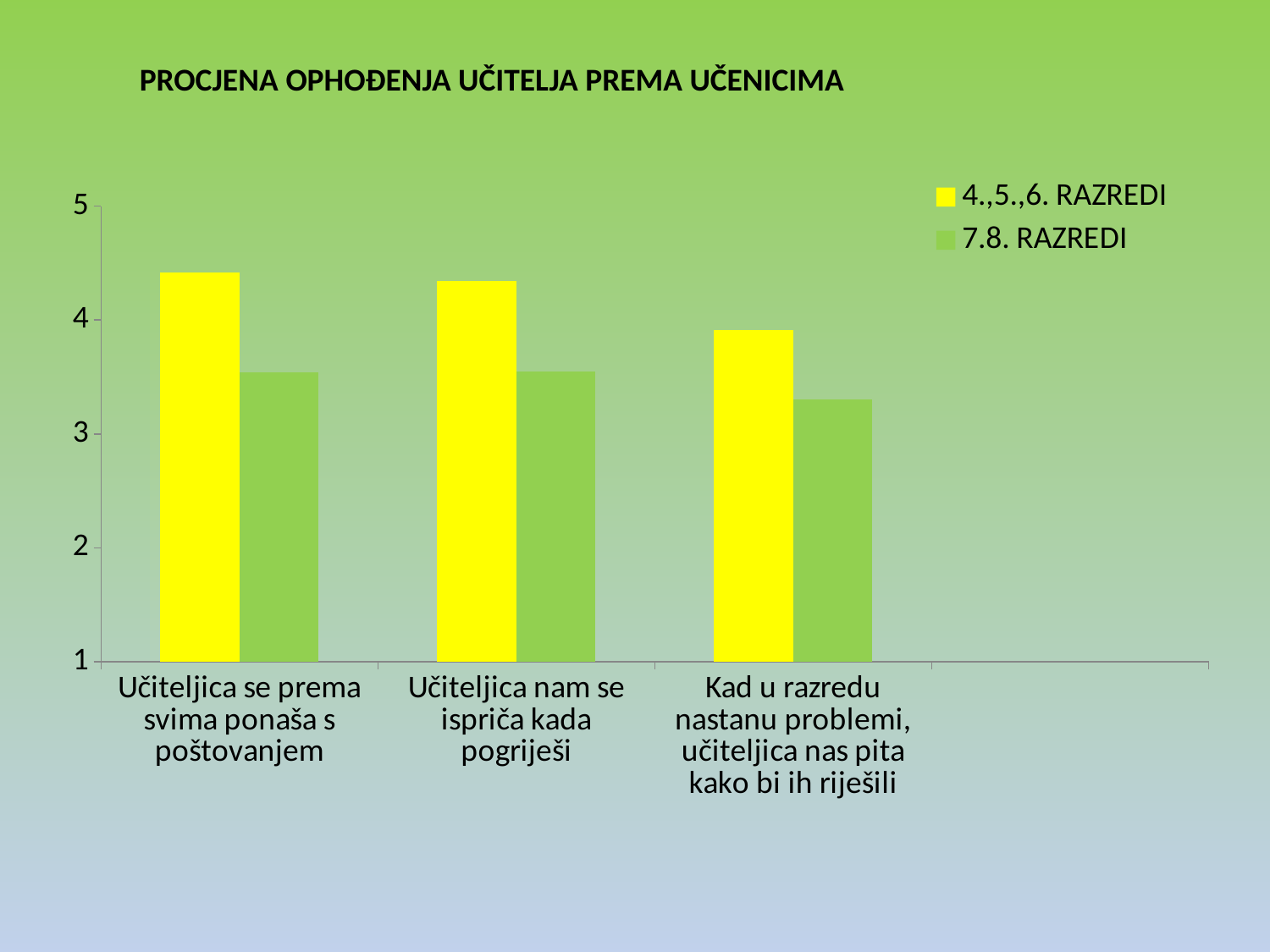
For the series 7.8. RAZREDI, which category has the lowest value? Kad u razredu nastanu problemi, učiteljica nas pita kako bi ih riješili Which series is shown in yellow in the chart? 4.,5.,6. RAZREDI Is the value for 7.8. RAZREDI in the category 'Kad u razredu nastanu problemi, učiteljica nas pita kako bi ih riješili' greater or less than 3? greater Is the value for 4.,5.,6. RAZREDI in the category 'Učiteljica se prema svima ponaša s poštovanjem' greater or less than 4? greater Is the value for 4.,5.,6. RAZREDI in the category 'Kad u razredu nastanu problemi, učiteljica nas pita kako bi ih riješili' greater or less than 4? less For the series 4.,5.,6. RAZREDI, which category has the lowest value? Kad u razredu nastanu problemi, učiteljica nas pita kako bi ih riješili How many series does the legend list? 2 What is the title of the chart? PROCJENA OPHOĐENJA UČITELJA PREMA UČENICIMA What kind of chart is shown on the slide? bar chart How many categories are shown on the x axis of the chart? 3 In the category 'Učiteljica se prema svima ponaša s poštovanjem', which series has the larger value, 4.,5.,6. RAZREDI or 7.8. RAZREDI? 4.,5.,6. RAZREDI